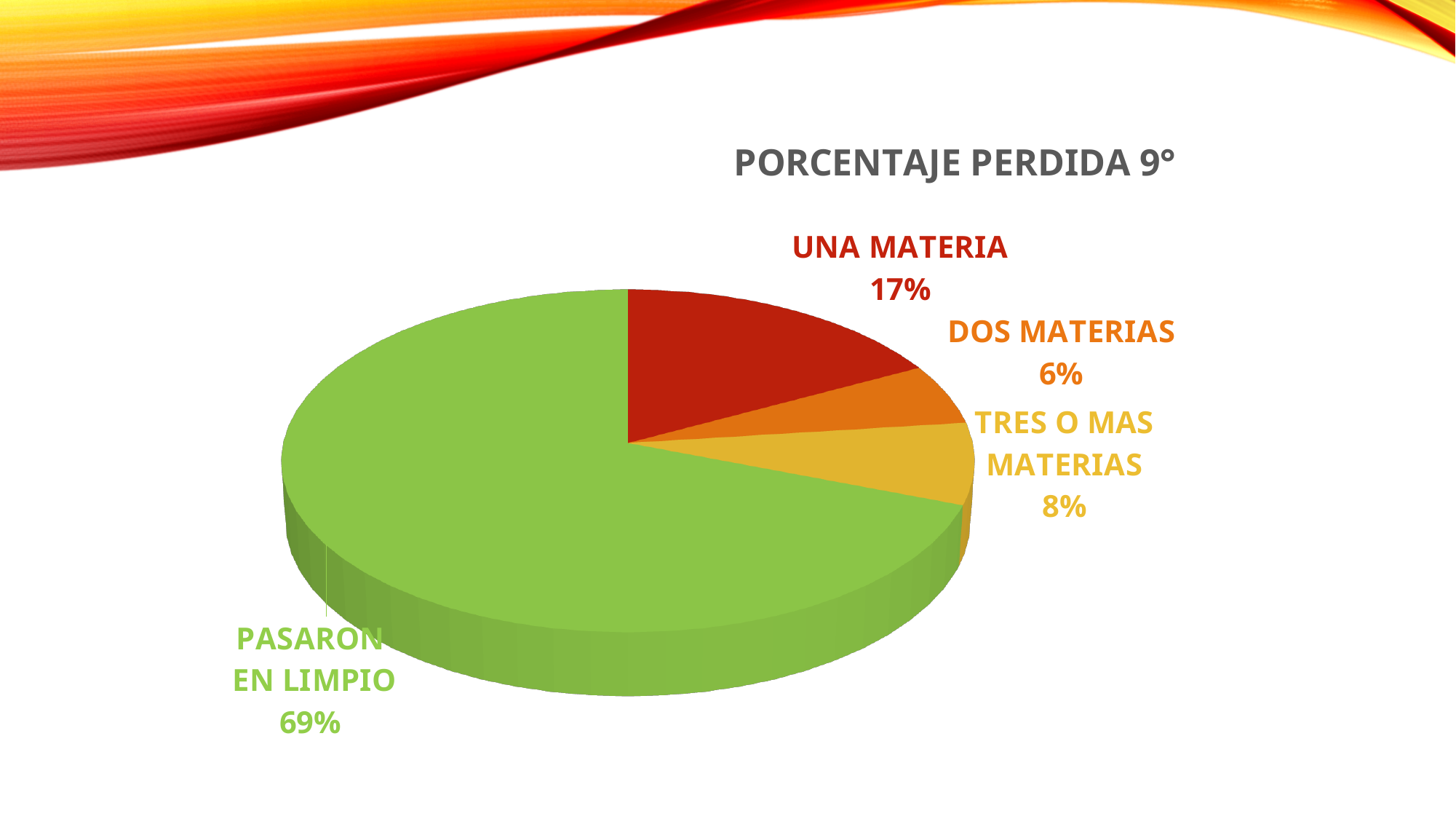
Which is larger, the share for DOS MATERIAS or the share for TRES O MAS MATERIAS? TRES O MAS MATERIAS What colour is the PASARON EN LIMPIO slice? Green What percentage is shown for PASARON EN LIMPIO? 69% Which category has the largest share of the pie? PASARON EN LIMPIO Which category has the smallest share of the pie? DOS MATERIAS What percentage is shown for UNA MATERIA? 17% What type of chart is shown on the slide? Pie chart What percentage is shown for DOS MATERIAS? 6% What is the difference in percentage points between UNA MATERIA and TRES O MAS MATERIAS? 9 What is the title of the chart? PORCENTAJE PERDIDA 9° How many categories are shown in the pie chart? 4 What percentage is shown for TRES O MAS MATERIAS? 8%